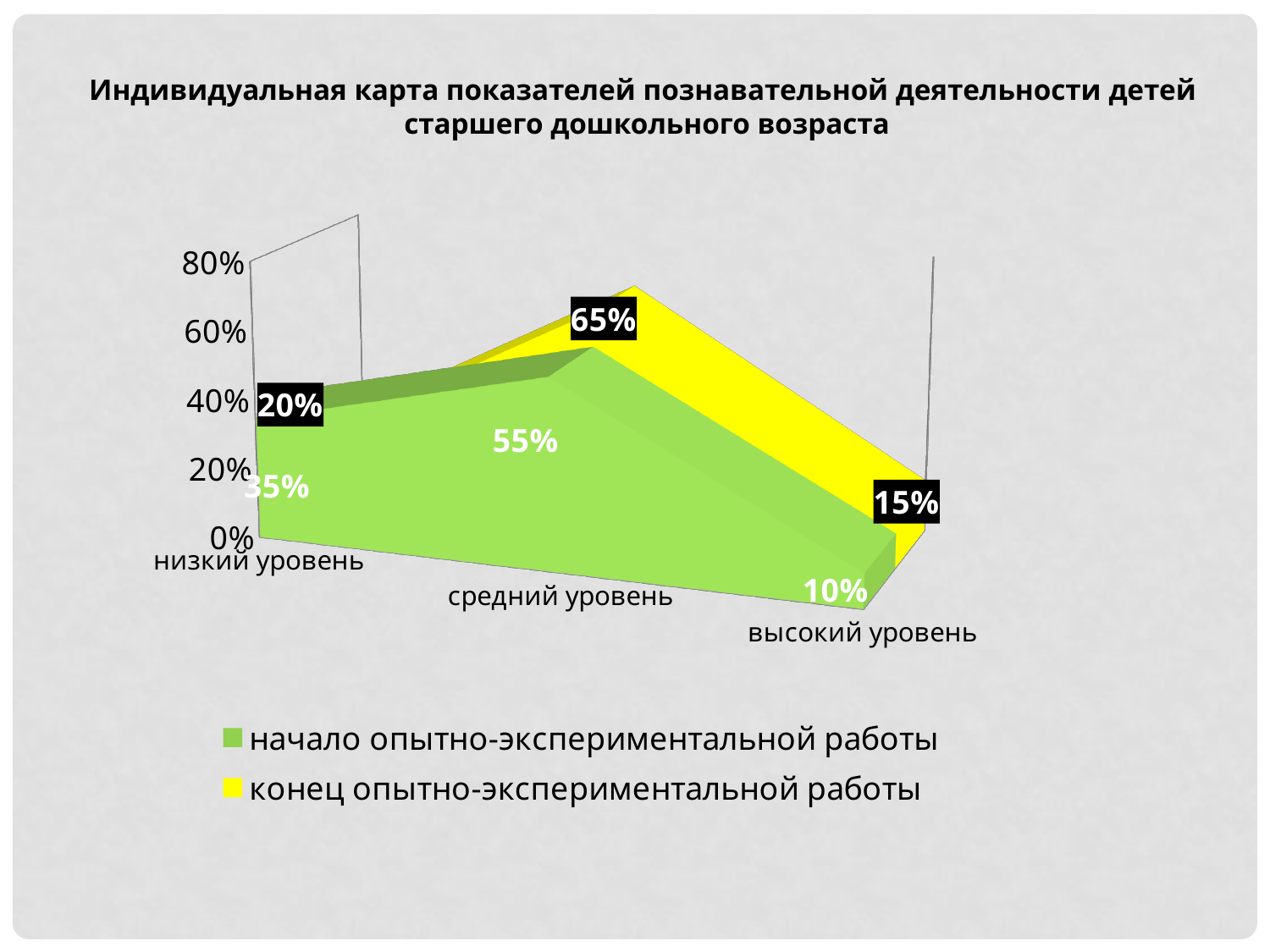
Which category has the highest value in the series "конец опытно-экспериментальной работы"? средний уровень Which colour represents the series "конец опытно-экспериментальной работы"? yellow How many series does the legend list? 2 What is the value for "высокий уровень" in the series "конец опытно-экспериментальной работы"? 15% What kind of chart is shown on the slide? area chart How many categories are shown on the x axis? 3 Which category has the lowest value in the series "начало опытно-экспериментальной работы"? высокий уровень For "низкий уровень", which series has the larger value? начало опытно-экспериментальной работы What is the difference between the "средний уровень" values of the two series? 10% What is the value for "высокий уровень" in the series "начало опытно-экспериментальной работы"? 10% What is the value for "средний уровень" in the series "начало опытно-экспериментальной работы"? 55% What is the value for "низкий уровень" in the series "конец опытно-экспериментальной работы"? 20%